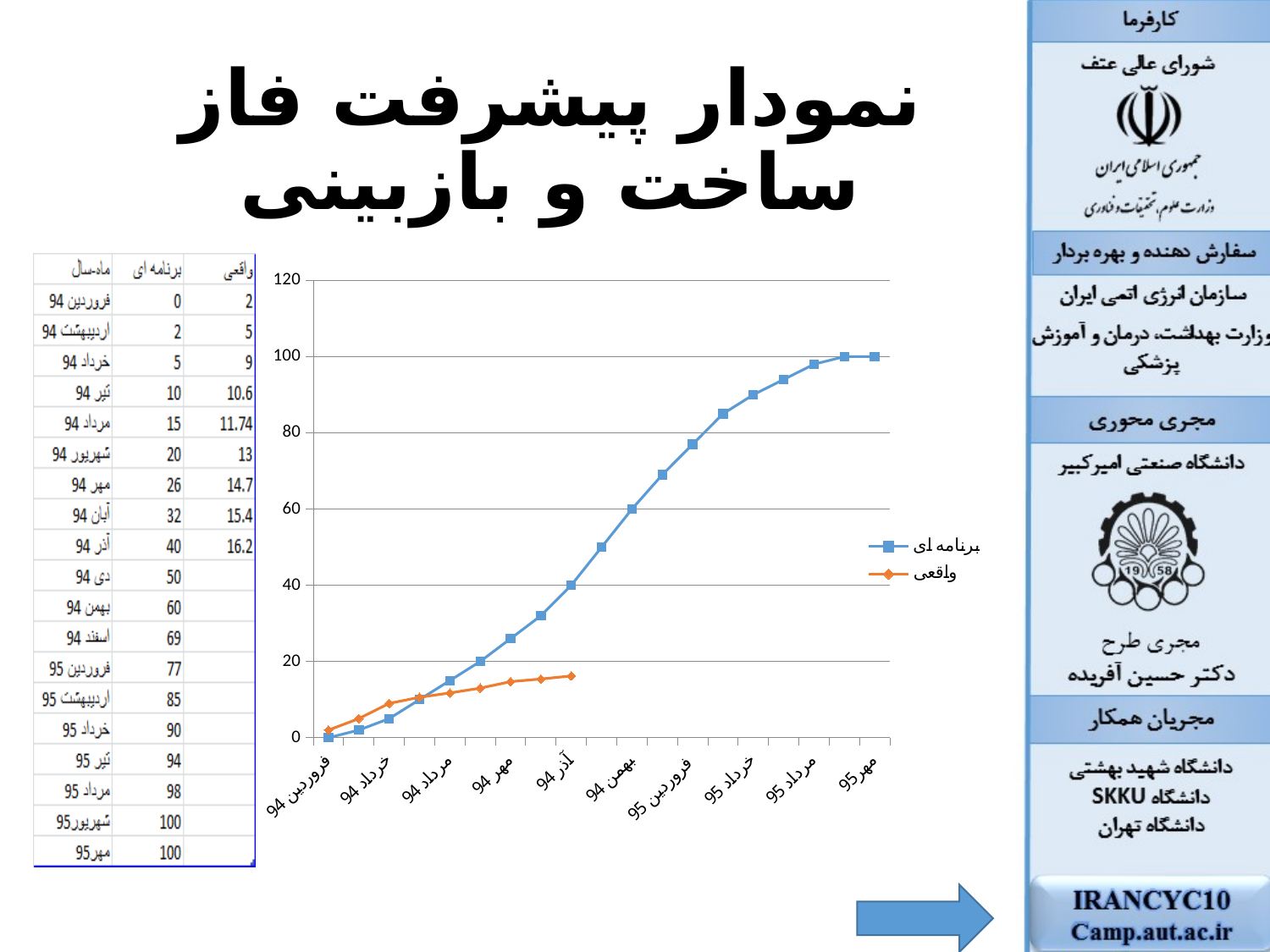
Using the values in the table, what is the difference between the برنامه ای and واقعی values at آذر 94? 23.8 At آذر 94, which series has the higher value, برنامه ای or واقعی? برنامه ای Is the value of the برنامه ای series at بهمن 94 greater or less than 40? greater What is the value of the برنامه ای series at مهر 95? 100 What is the value of the برنامه ای series at فروردین 94? 0 What are the two series named in the chart legend? برنامه ای and واقعی How many data points does the واقعی series have on the chart? 9 How many series does the chart legend list? 2 According to the data table on the slide, what is the واقعی value for مرداد 94? 11.74 Does the برنامه ای series rise or fall from فروردین 94 to مهر 95? rise Is the value of the واقعی series at آذر 94 greater or less than 20? less What kind of chart is shown on the slide? line chart